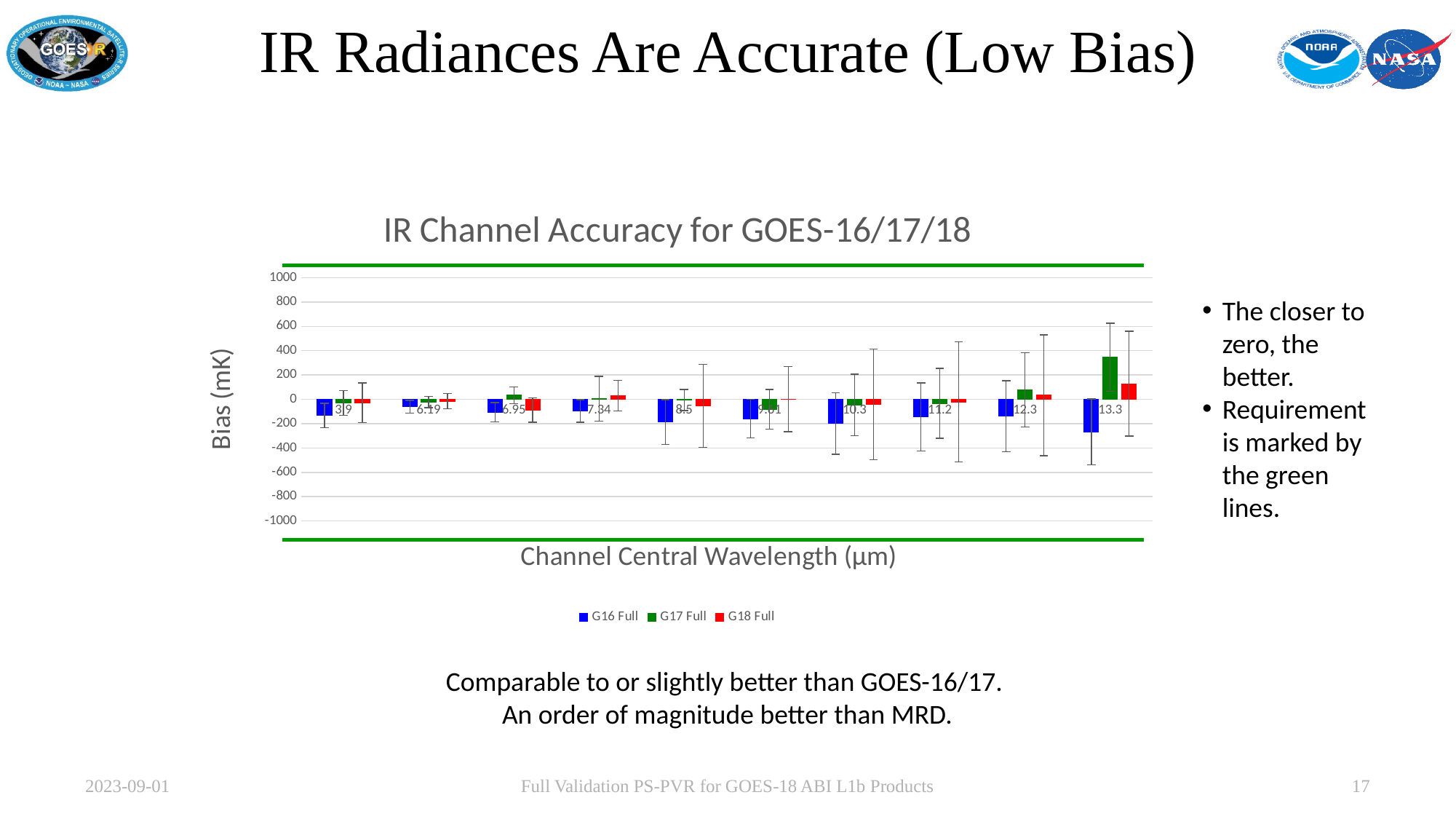
How many series does the legend of the chart list? 3 Is the G16 Full value at 13.3 greater or less than 0? less Which series has the lowest (most negative) bar in the chart, and at which wavelength? G16 Full at 13.3 Which series has the highest bar in the chart, and at which wavelength? G17 Full at 13.3 Which is lower: the G16 Full value at 13.3 or the G16 Full value at 3.9? G16 Full at 13.3 What kind of chart is shown on the slide? bar chart How many channel central wavelength categories are plotted on the x axis? 10 At 13.3, which is larger: the G17 Full value or the G18 Full value? G17 Full What is the title of the chart? IR Channel Accuracy for GOES-16/17/18 Is the G17 Full value at 13.3 greater or less than 200? greater Is the G18 Full value at 13.3 greater or less than 0? greater What is the label of the vertical axis of the chart? Bias (mK)